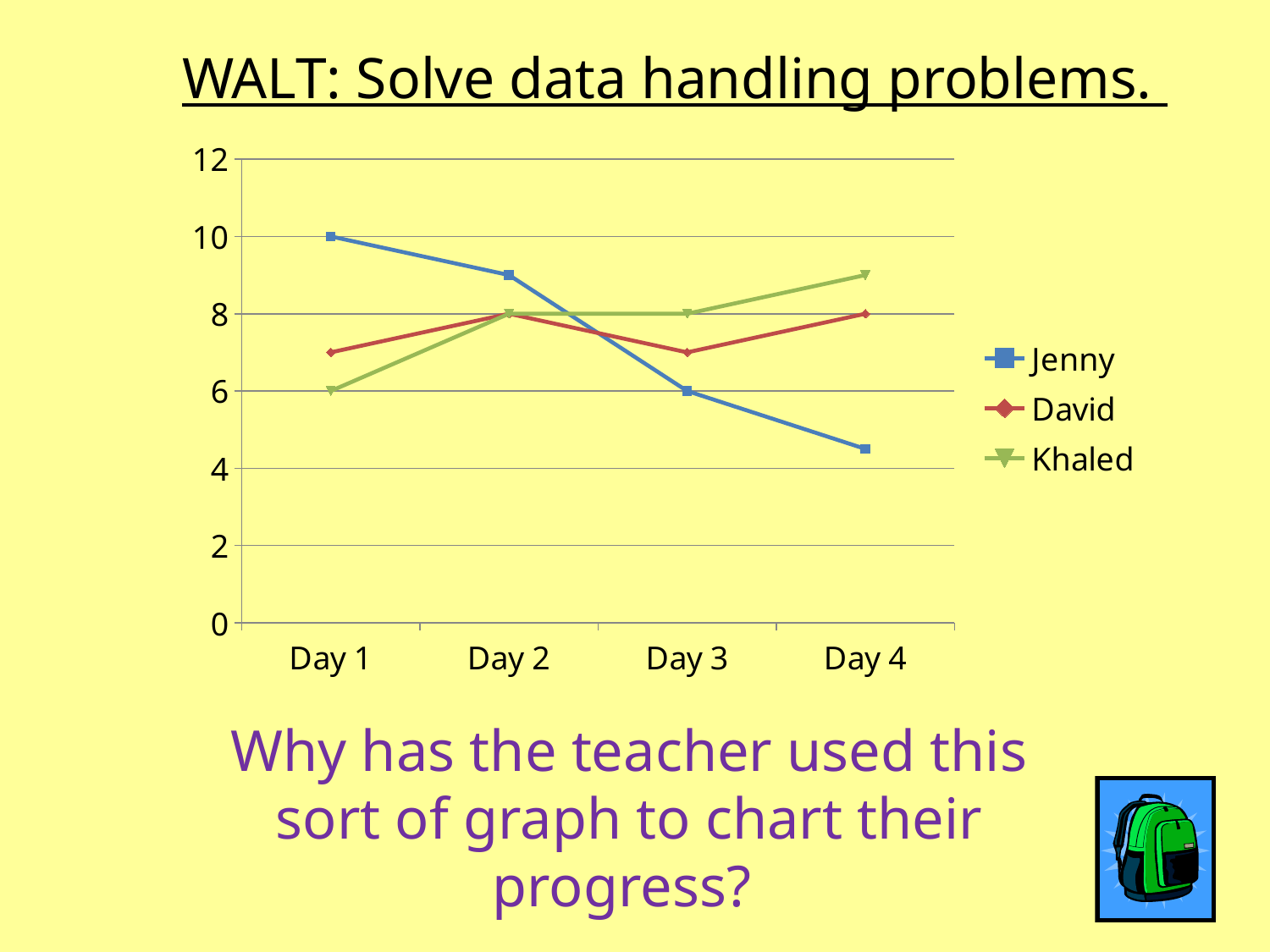
What is Khaled's value on Day 1? 6 Is Jenny's value on Day 4 greater or less than 6? less What is Jenny's value on Day 1? 10 What type of chart is shown on the slide? Line chart Which person has the highest value on Day 1? Jenny Is Khaled's value on Day 4 greater or less than 8? greater Which person has the lowest value on Day 4? Jenny What is David's value on Day 2? 8 How many series does the legend list? 3 What is the difference between Jenny's value on Day 1 and her value on Day 3? 4 How many days are shown on the x axis? 4 Do Jenny's values rise or fall from Day 1 to Day 4? Fall